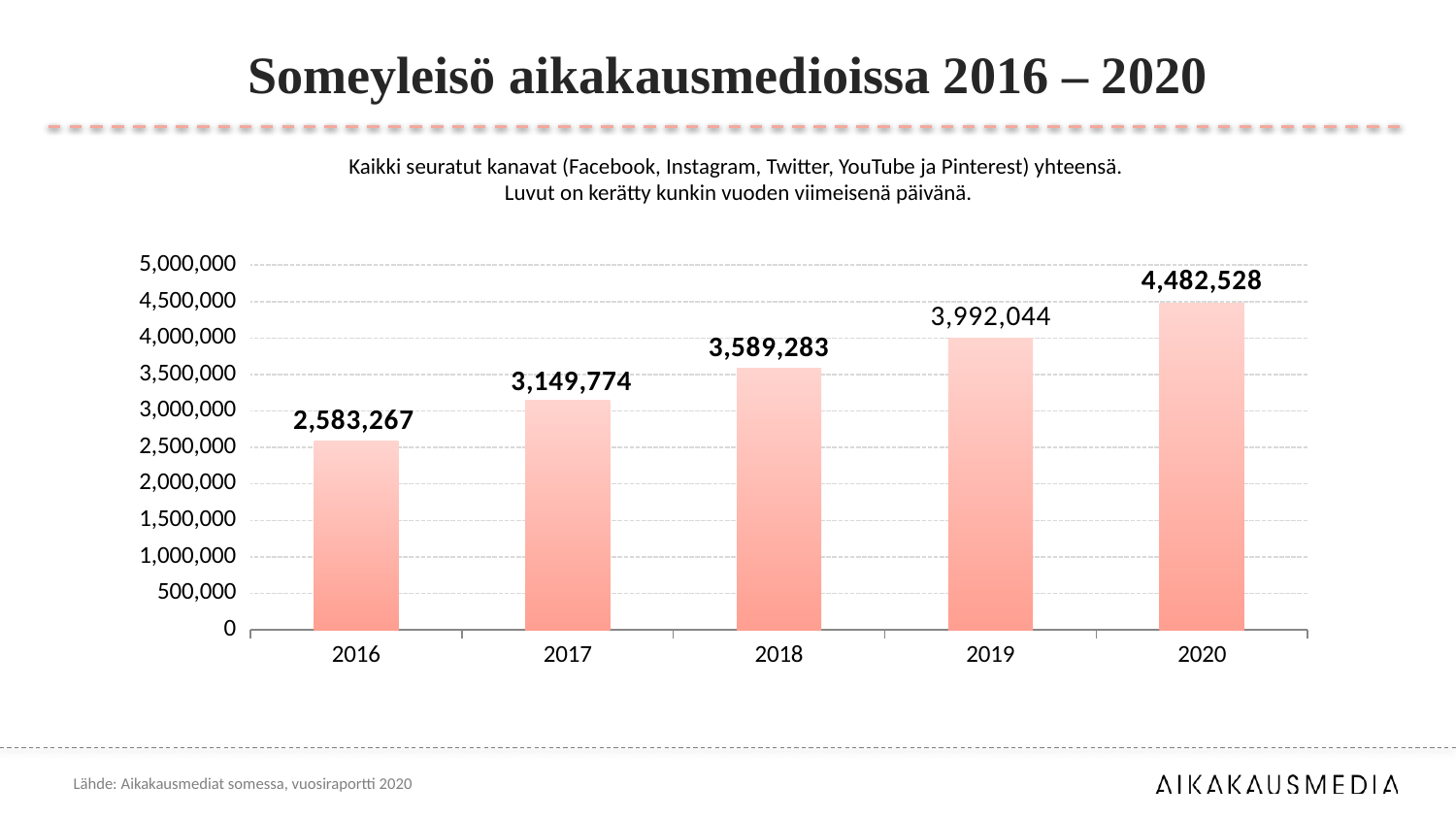
How many years are shown on the x axis? 5 Which year has the lowest value? 2016 Which is larger, the value for 2018 or the value for 2019? 2019 What is the difference between the values for 2017 and 2016? 566,507 What is the value for 2020? 4,482,528 What is the difference between the values for 2020 and 2019? 490,484 What is the value for 2018? 3,589,283 What is the value for 2016? 2,583,267 What kind of chart is shown on the slide? bar chart Do the values rise or fall from 2016 to 2020? rise Which year has the highest value? 2020 Is the value for 2019 greater or less than 3,500,000? greater